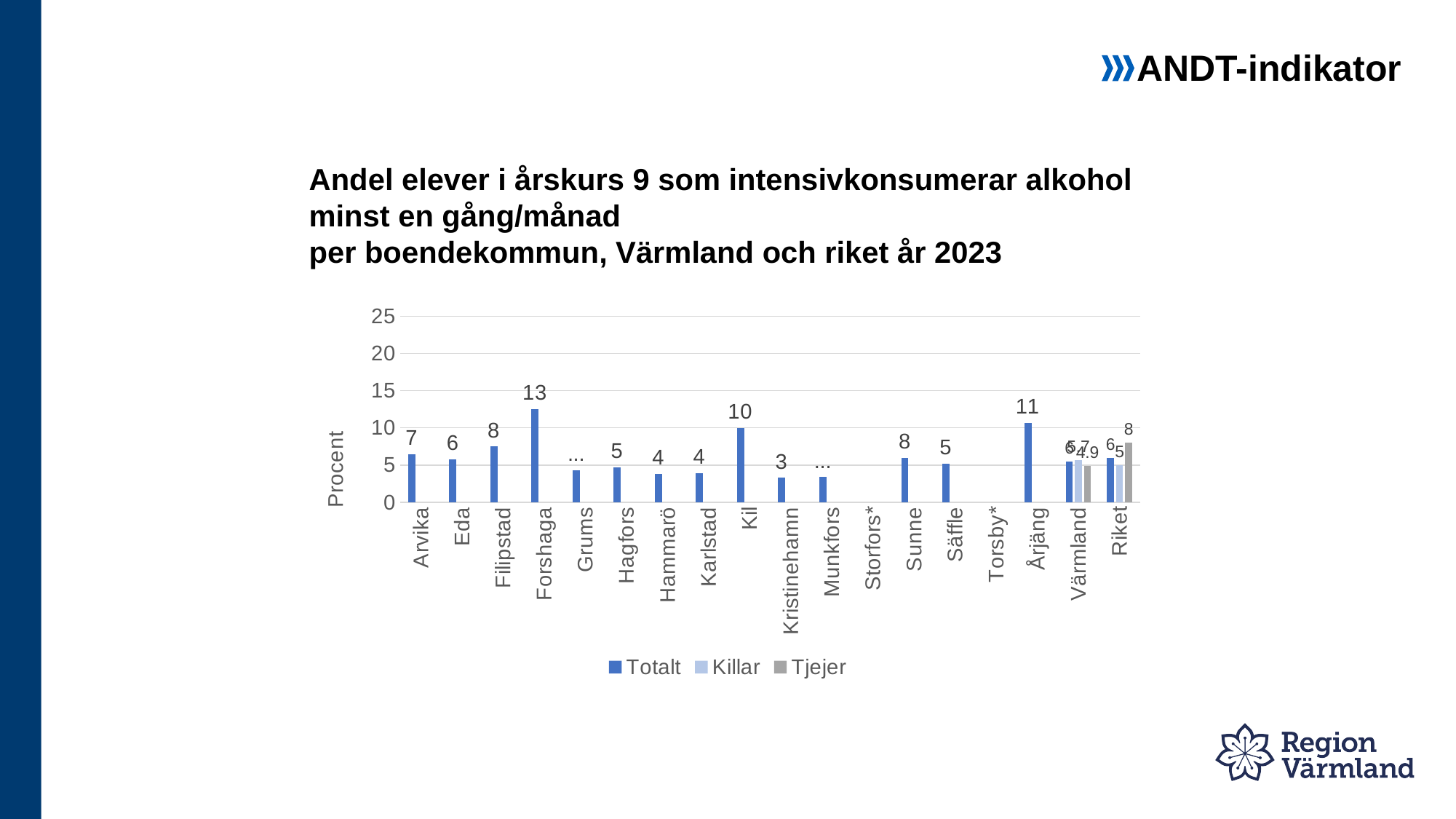
For Riket, what is the difference between the Tjejer and Killar values? 3 Which has a larger Totalt value, Årjäng or Kil? Årjäng How many series does the legend list? 3 Is the Totalt value for Kristinehamn greater or less than 5? less What is the Killar value for Riket? 5 What is the Totalt value for Forshaga? 13 What kind of chart is shown on the slide? bar chart How many categories are shown on the x axis? 18 Which municipality has the highest Totalt value? Forshaga What is the Totalt value for Kil? 10 What is the difference between the Totalt values for Forshaga and Kil? 3 What is the Tjejer value for Riket? 8